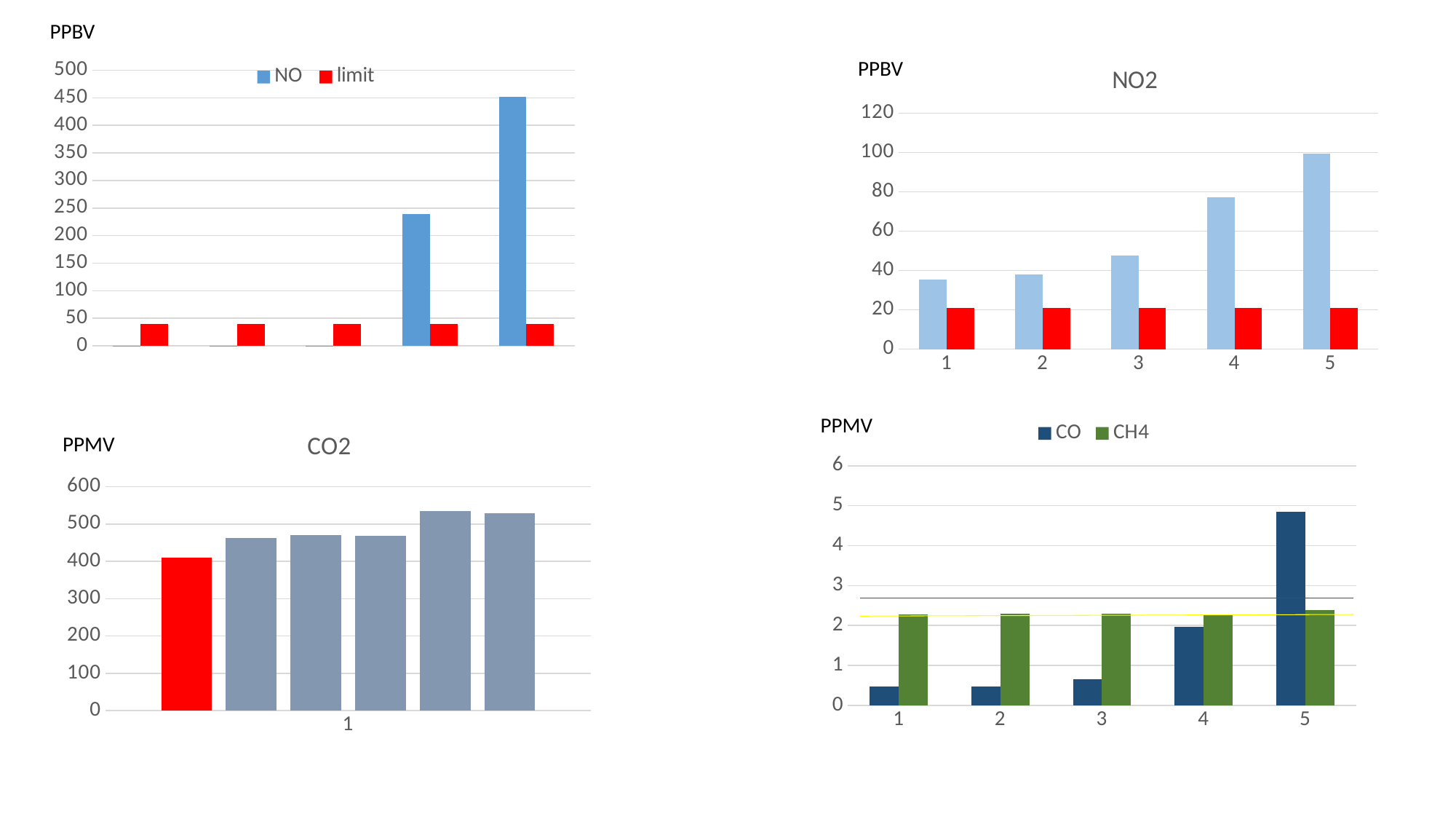
In the top-left chart, is the tallest NO bar greater or less than 400? greater In the bottom-right chart, which series is larger for category 1, CO or CH4? CH4 In the top-left chart, how many series does the legend list? 2 In the bottom-right chart, which category has the highest CO bar? 5 In the NO2 chart, is the blue bar for category 5 greater or less than 80? greater In the NO2 chart, which category has the highest blue bar? 5 In the NO2 chart, how many categories are shown on the x axis? 5 In the NO2 chart, do the blue bars rise or fall from category 1 to category 5? rise In the bottom-right chart, is the CO bar for category 5 greater or less than 4? greater What kind of chart is the NO2 chart in the top right of the slide? bar chart In the CO2 chart, how many bars are plotted? 6